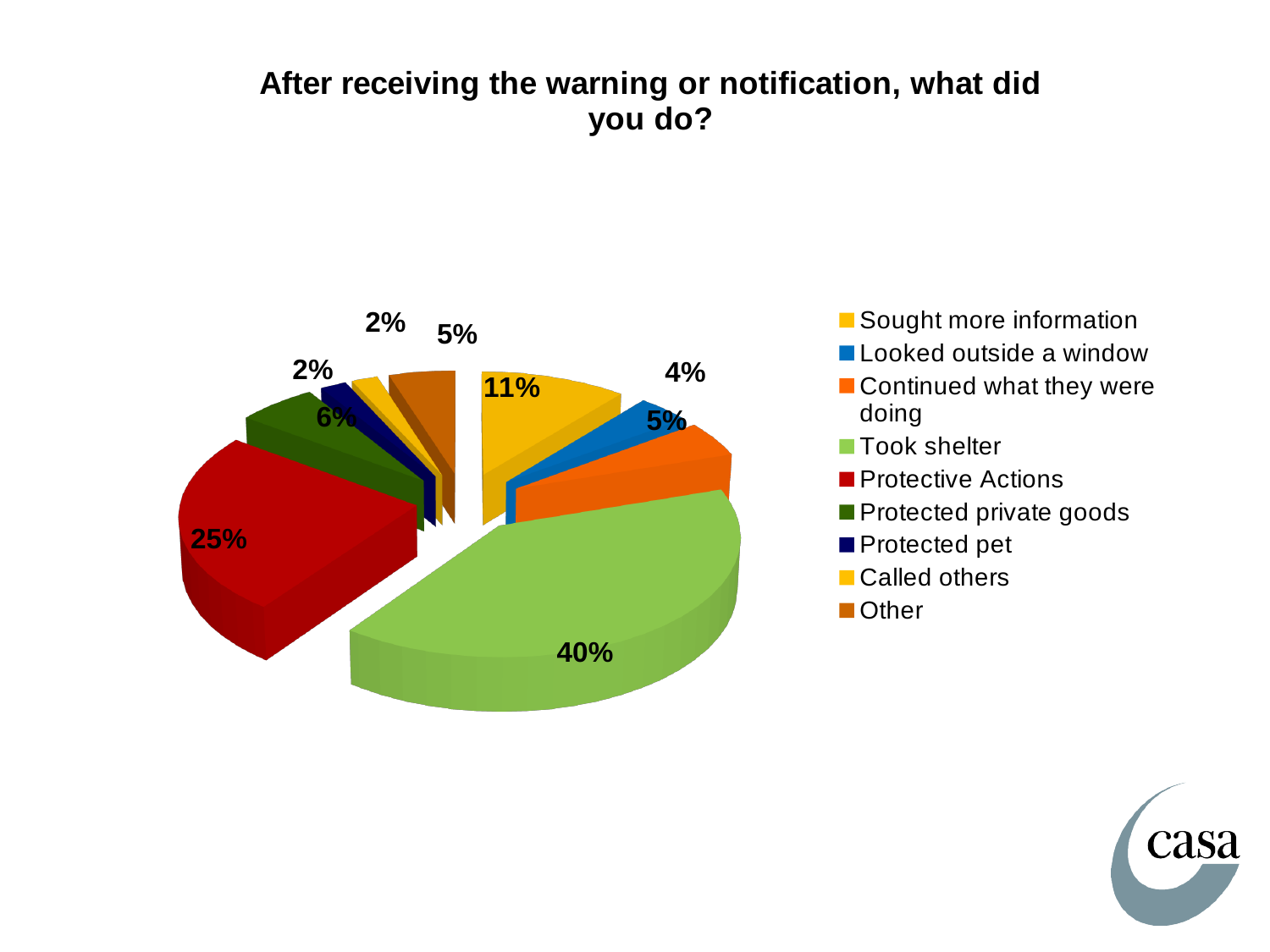
What share of the pie is labelled Protective Actions? 25% What percentage of respondents took shelter? 40% What is the difference in percentage points between Took shelter and Protective Actions? 15 What kind of chart is shown on the slide? Pie chart What colour is the slice for Took shelter? Green How many categories does the legend list? 9 Which is larger: the share for Sought more information or the share for Protected private goods? Sought more information What percentage of respondents sought more information? 11% Which response category has the largest share of the pie? Took shelter What percentage of respondents protected private goods? 6% What percentage of respondents looked outside a window? 4% What is the title of the chart? After receiving the warning or notification, what did you do?